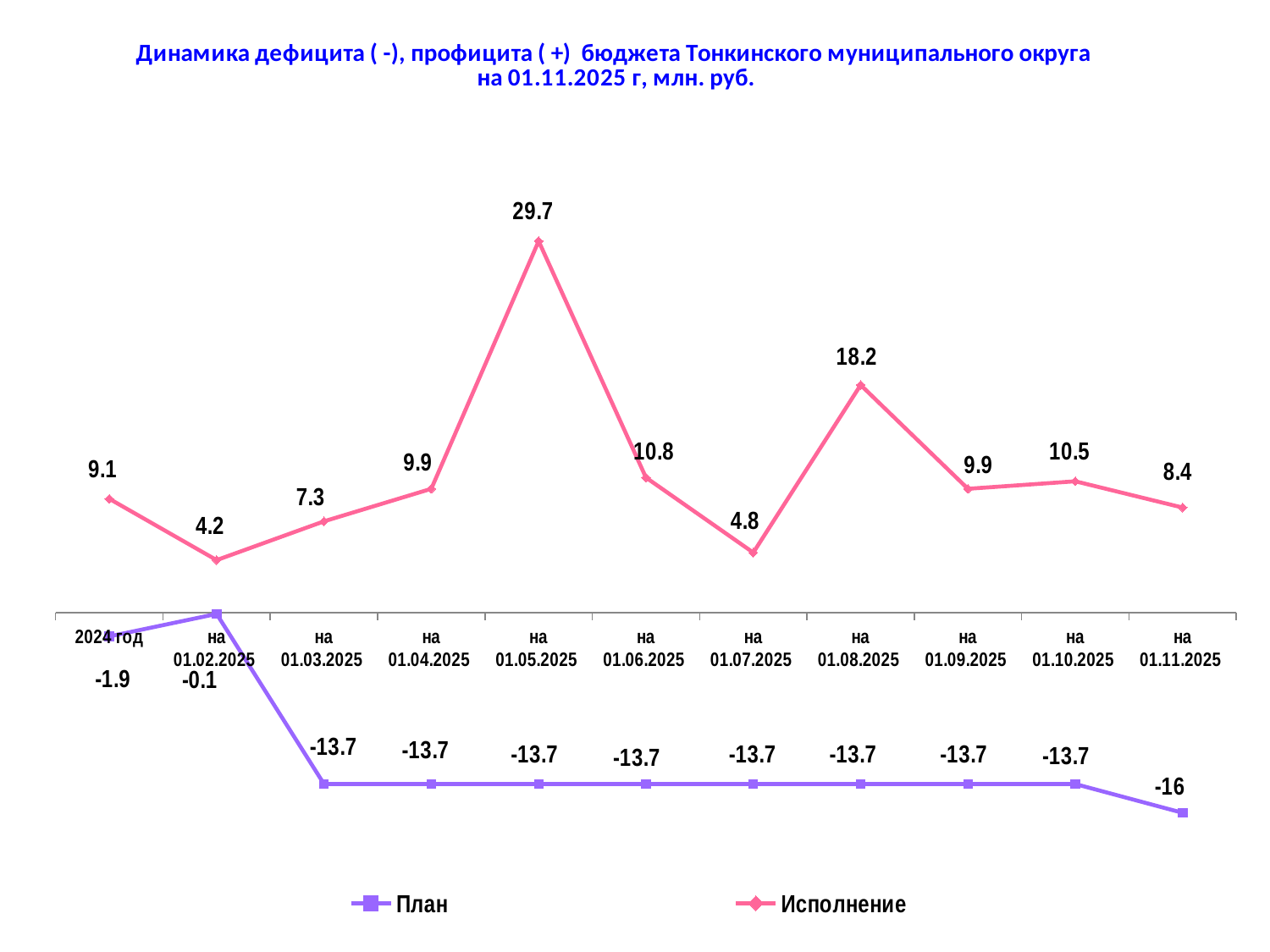
At which date is the Исполнение series lowest? на 01.02.2025 At which date does the Исполнение series reach its highest value? на 01.05.2025 What is the difference between Исполнение and План on 01.11.2025? 24.4 What is the value of План on 01.02.2025? -0.1 What type of chart is shown on the slide? line chart Which is larger: Исполнение on 01.08.2025 or Исполнение on 01.06.2025? Исполнение on 01.08.2025 Which series is drawn in pink? Исполнение What is the value of План on 01.11.2025? -16 What is the value of Исполнение for 2024 год? 9.1 How many data points does the Исполнение series have? 11 How many series does the legend list? 2 What is the value of Исполнение on 01.05.2025? 29.7